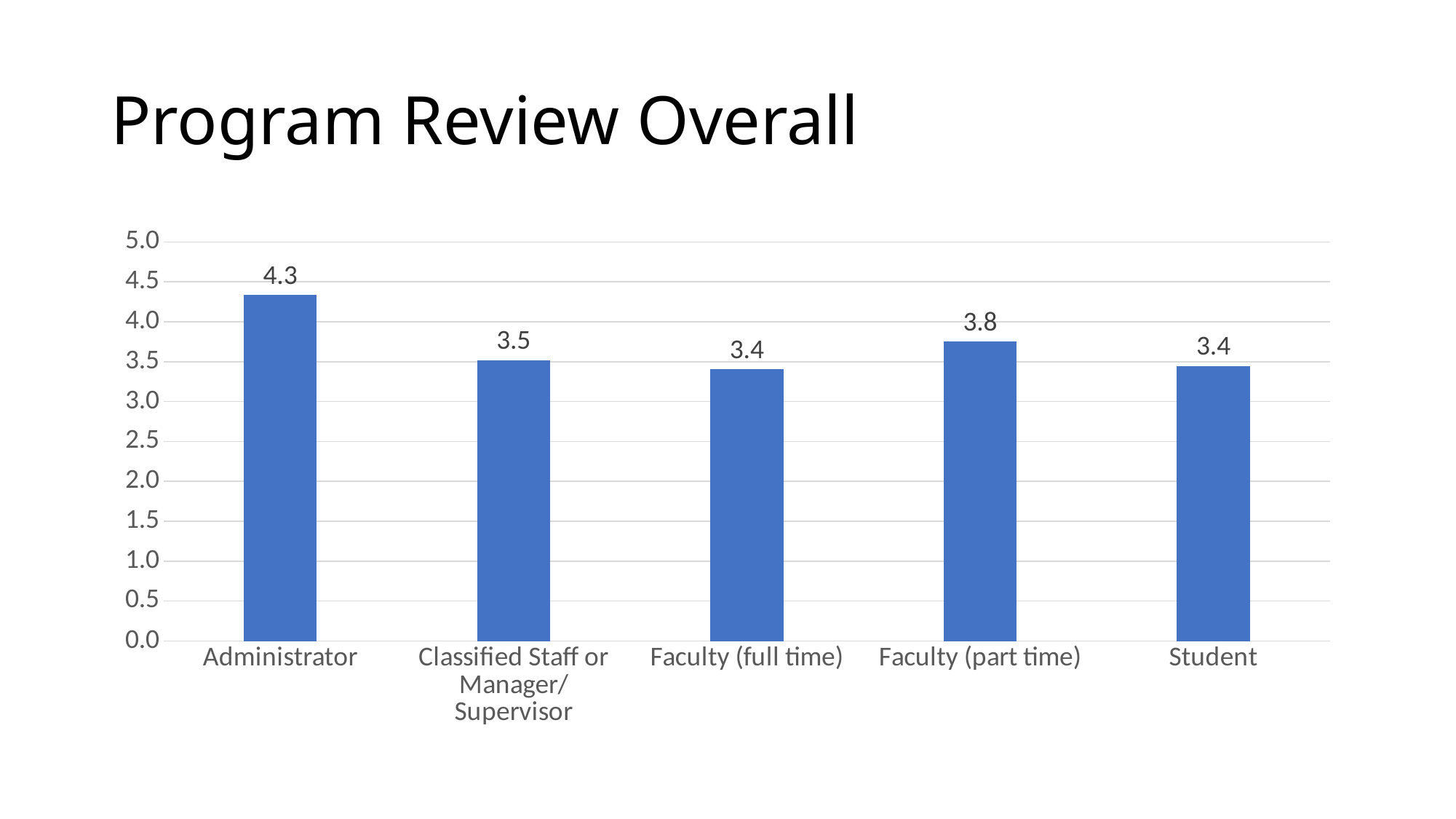
What is the value for Faculty (part time)? 3.8 Which category has the highest value? Administrator What is the value for Student? 3.4 What is the value for Administrator? 4.3 What is the value for Classified Staff or Manager/Supervisor? 3.5 What is the difference between the values for Administrator and Faculty (part time)? 0.5 Is the value for Administrator greater or less than 4.0? greater What is the title of the slide? Program Review Overall Which is larger, the value for Faculty (part time) or the value for Classified Staff or Manager/Supervisor? Faculty (part time) How many categories are shown on the x axis? 5 What kind of chart is shown on the slide? bar chart What is the difference between the values for Faculty (part time) and Faculty (full time)? 0.4